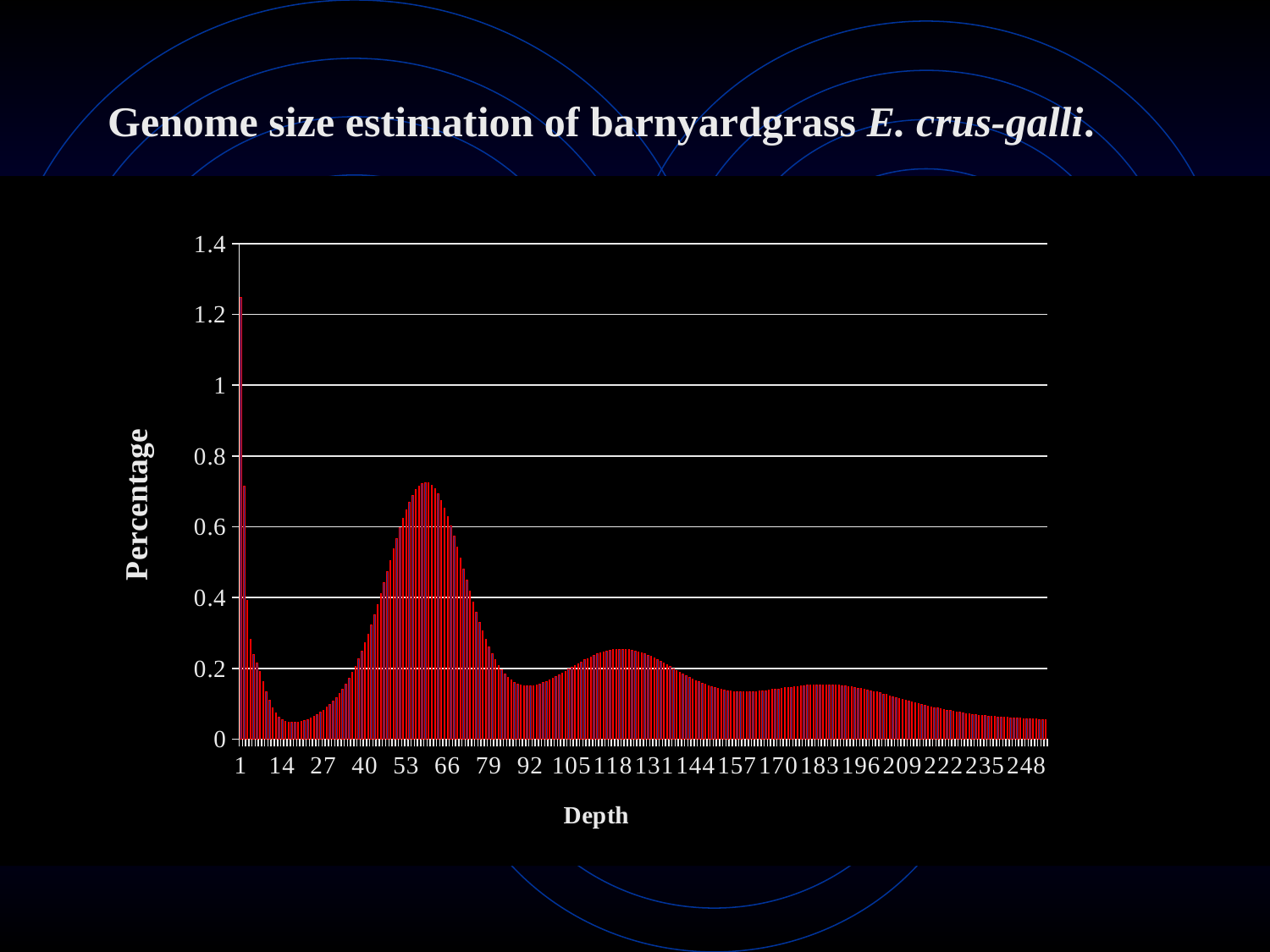
Which depth has the larger percentage, 1 or 66? 1 What is the title of the slide's chart? Genome size estimation of barnyardgrass E. crus-galli. What kind of chart is shown on the slide? bar chart Is the highest percentage in the peak around depth 53-66 greater or less than 0.8? less Is the percentage at depth 1 greater or less than 1? greater At which depth is the percentage highest? 1 What are the x-axis and y-axis titles of the chart? Depth (x-axis) and Percentage (y-axis) Do the percentages rise or fall as depth increases from 196 to 248? fall Do the percentages rise or fall as depth increases from 27 to 53? rise Is the percentage at depth 27 greater or less than 0.2? less Which depth has the larger percentage, 53 or 118? 53